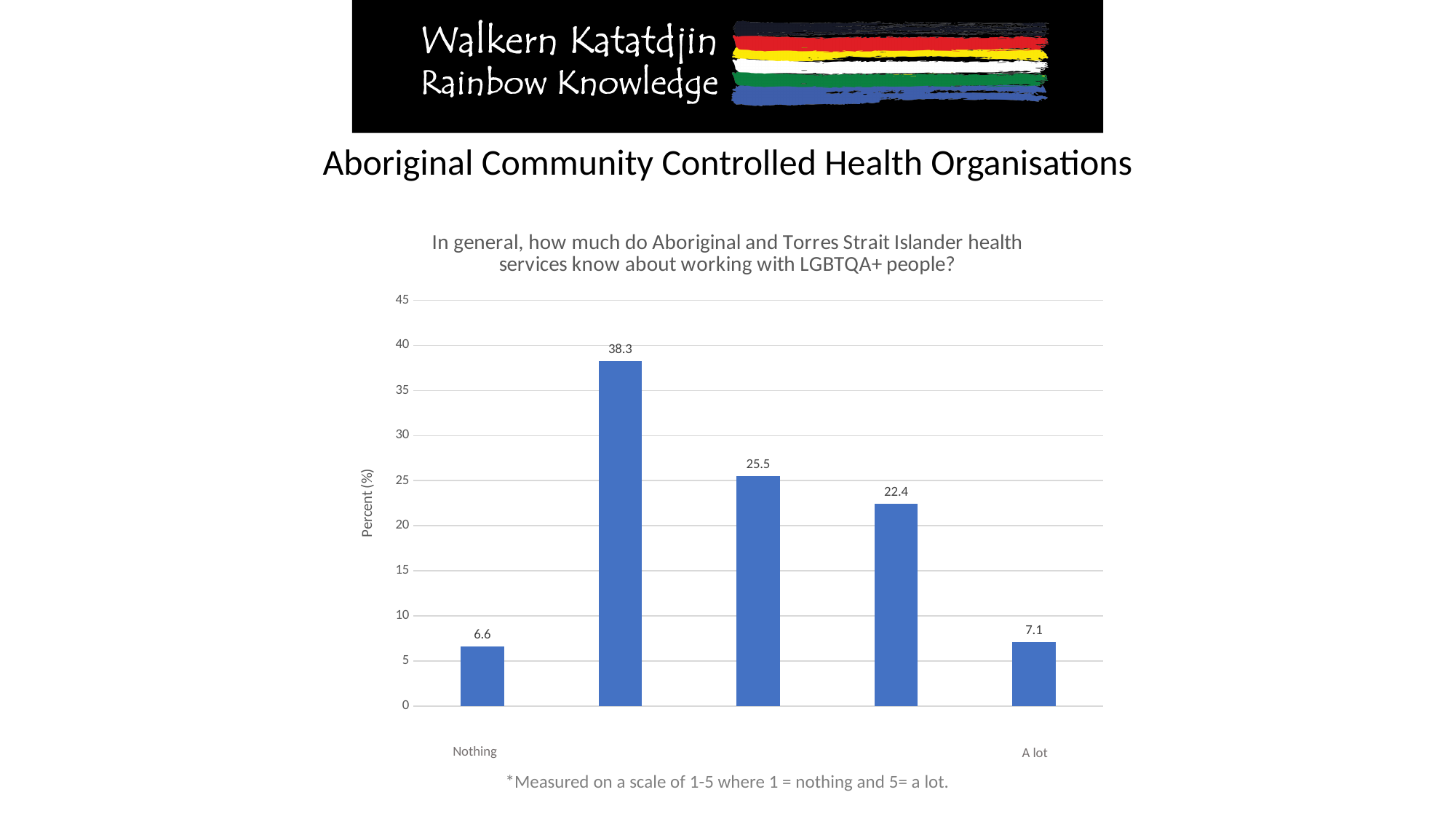
What is the value for the "A lot" category? 7.1 Is the value of the tallest bar greater or less than 35? greater What is the difference between the "A lot" value and the "Nothing" value? 0.5 What kind of chart is shown on the slide? bar chart What is the value of the tallest bar in the chart? 38.3 What is the value for the "Nothing" category? 6.6 Which labelled category, "Nothing" or "A lot", has the larger value? A lot What is the difference between the highest bar (38.3) and the lowest bar (6.6)? 31.7 Is the value for "Nothing" greater or less than 10? less What is the value of the third bar from the left? 25.5 What is the label of the vertical axis? Percent (%) How many bars are plotted in the chart? 5